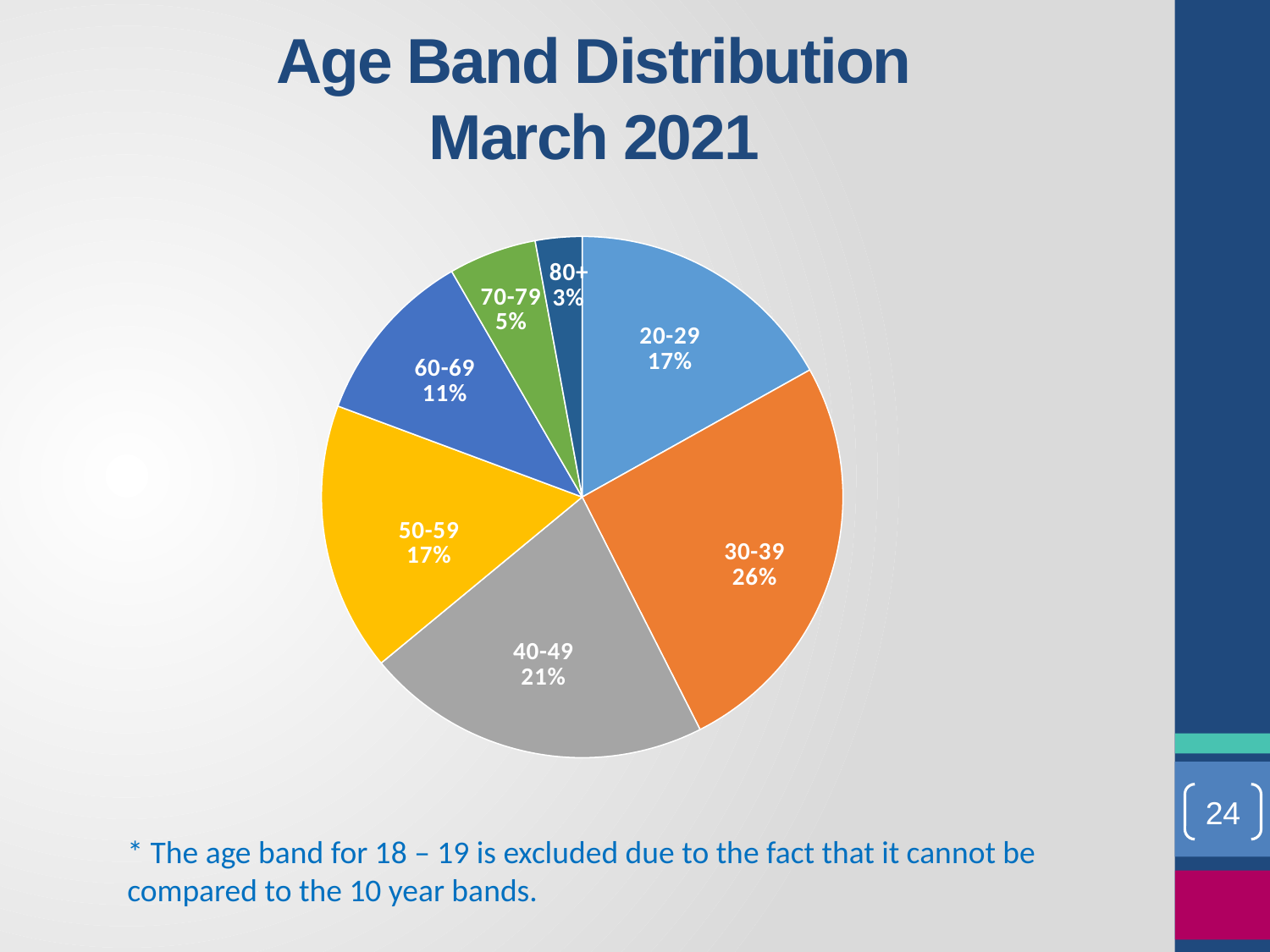
What percentage is shown for the 80+ age band? 3% What is the difference in percentage points between the 30-39 and 40-49 age bands? 5 Which has a larger share, the 60-69 age band or the 70-79 age band? 60-69 What is the difference in percentage points between the 20-29 and 80+ age bands? 14 What kind of chart is shown on the slide? pie chart How many age bands are shown in the pie chart? 7 What is the title of the slide containing the pie chart? Age Band Distribution March 2021 What percentage is shown for the 40-49 age band? 21% Which age band has the largest share of the pie? 30-39 Which age band has the smallest share of the pie? 80+ What share of the pie does the 30-39 age band have? 26% What percentage is shown for the 60-69 age band? 11%